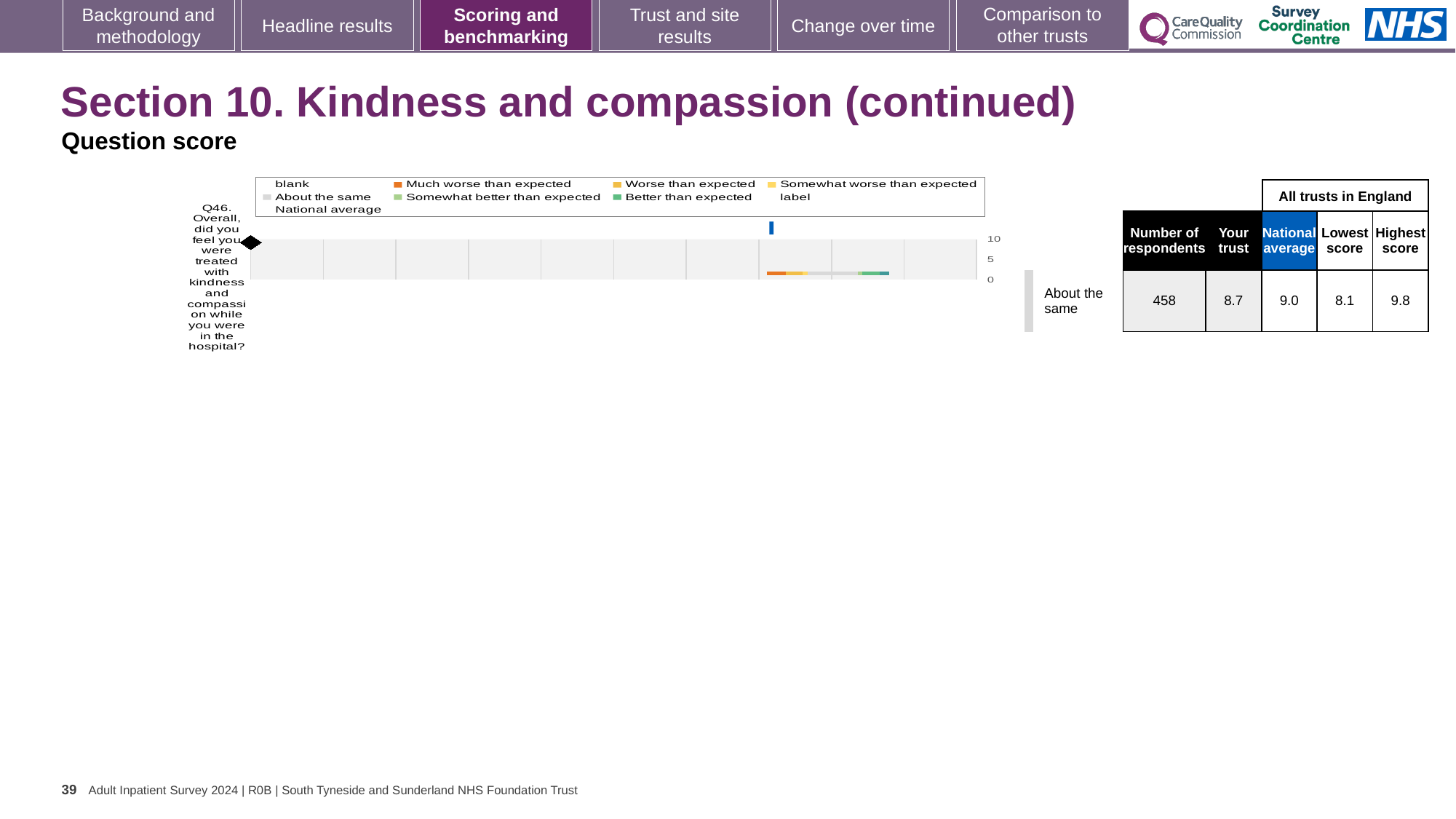
What is the highest value shown on the chart's score axis? 10 What is the national average score for Q46? 9.0 What is the 'Your trust' score for Q46? 8.7 How many respondents answered Q46? 458 Is the national average marker for Q46 greater or less than 5 on the score axis? greater What is the lowest score among all trusts in England for Q46? 8.1 What is the difference between the highest score and the lowest score for Q46? 1.7 How many questions are plotted on the chart? 1 What is the highest score among all trusts in England for Q46? 9.8 Which question number is plotted on the chart? Q46 What kind of chart is used to show the Q46 question score? bar chart Which is larger for Q46, the 'Your trust' score or the national average? National average